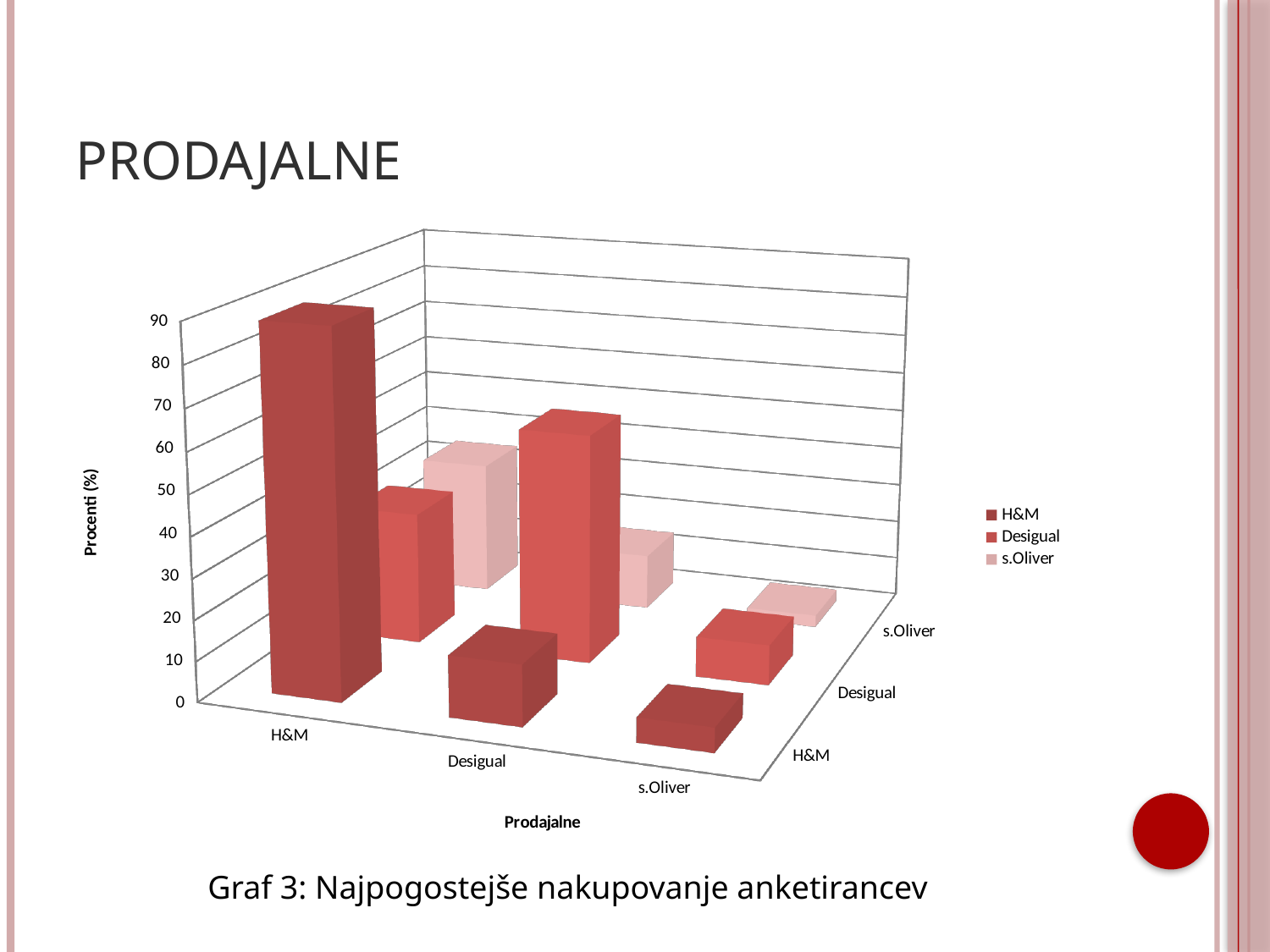
Is the value of the H&M series for the H&M category greater or less than 50? greater How many series does the legend list? 3 Is the value of the s.Oliver series for the s.Oliver category greater or less than 20? less In which category does the H&M series reach its highest value? H&M Which is larger in the Desigual category: the Desigual series or the s.Oliver series? Desigual How many categories are shown on the x axis of the chart? 3 What kind of chart is shown on the slide? bar chart Is the value of the Desigual series for the Desigual category greater or less than 30? greater What is the title of the vertical axis of the chart? Procenti (%) Which series has the tallest bar in the chart? H&M Which is larger: the H&M series value for the H&M category or the Desigual series value for the Desigual category? H&M series value for the H&M category